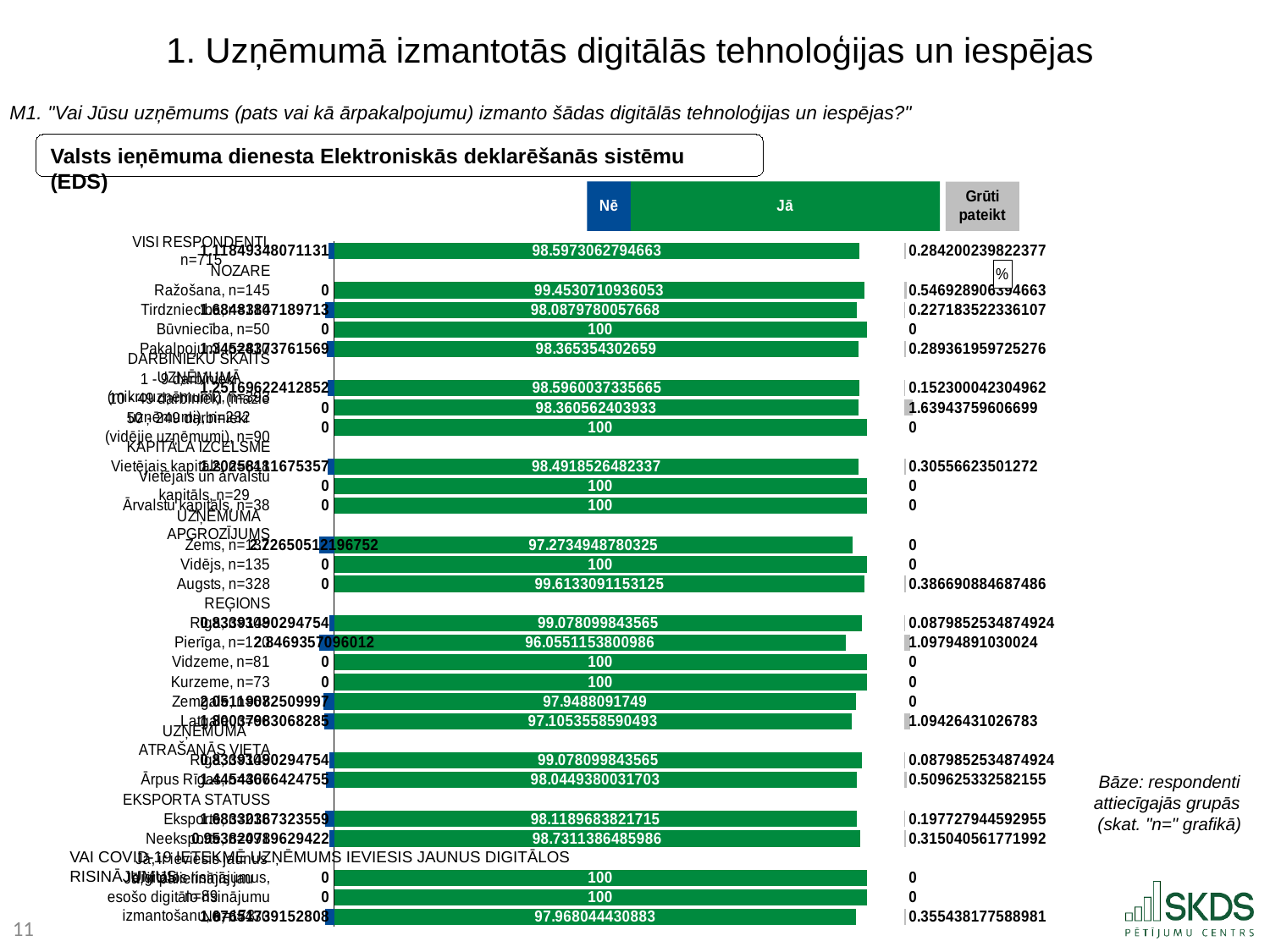
What is the "Nē" value for Vidzeme, n=81? 0 What is the total of the stacked bar for Būvniecība, n=50? 100 Which legend entry is shown in green? Jā Which category has the lowest "Jā" value? Pierīga What is the "Grūti pateikt" value for Latgale? 1.09426431026783 How many series does the legend list? 3 What kind of chart is shown on the slide? bar chart What is the "Jā" value for Pierīga? 96.0551153800986 What is the difference between the "Jā" values for Vidzeme, n=81 and Pierīga? 3.9448846199014 Which has a larger "Jā" value, Pierīga or Vidzeme, n=81? Vidzeme, n=81 What is the "Jā" value for VISI RESPONDENTI, n=715? 98.5973062794663 What is the "Jā" value for Būvniecība, n=50? 100